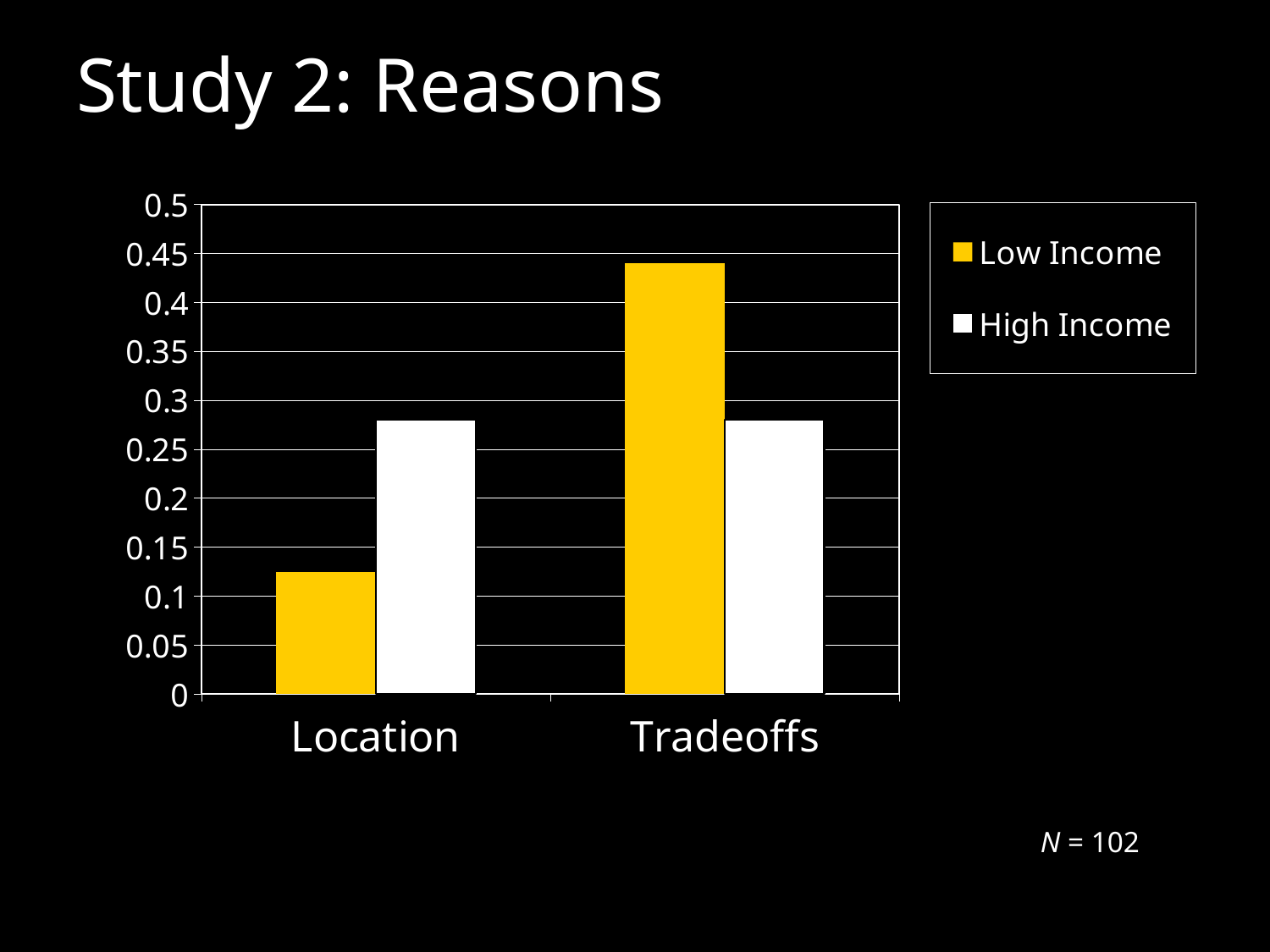
Which series is shown in yellow? Low Income For Location, which series has the larger value, Low Income or High Income? High Income What kind of chart is shown on the slide? bar chart How many categories are shown on the x axis? 2 Is the High Income value for Tradeoffs greater or less than 0.3? less What is the title of the slide containing the chart? Study 2: Reasons Is the Low Income value for Tradeoffs greater or less than 0.4? greater How many series does the legend list? 2 Is the High Income value for Location greater or less than 0.25? greater Which category has the highest Low Income value? Tradeoffs For Tradeoffs, which series has the larger value, Low Income or High Income? Low Income